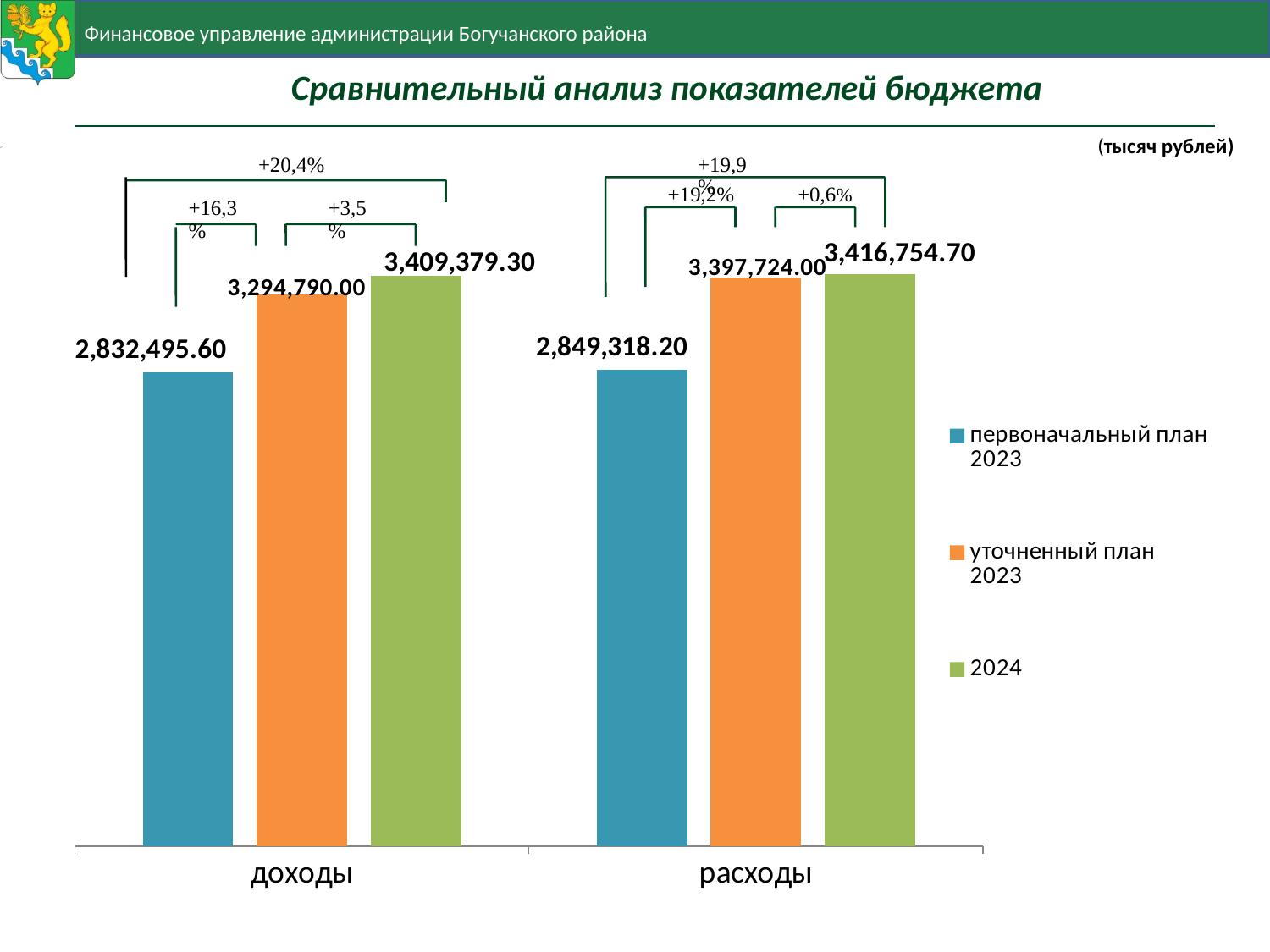
How many series does the legend list? 3 What is the value of уточненный план 2023 for расходы? 3,397,724.00 What is the value of 2024 for расходы? 3,416,754.70 What unit is stated for the values on the chart? тысяч рублей What is the difference between the 2024 value and the первоначальный план 2023 value for доходы? 576,883.70 Which is larger: the 2024 value for доходы or the 2024 value for расходы? 2024 value for расходы What type of chart is shown on the slide? bar chart What is the value of первоначальный план 2023 for доходы? 2,832,495.60 Which series has the lowest value for расходы? первоначальный план 2023 What is the value of уточненный план 2023 for доходы? 3,294,790.00 How many categories are shown on the x axis? 2 Which series has the highest value for доходы? 2024